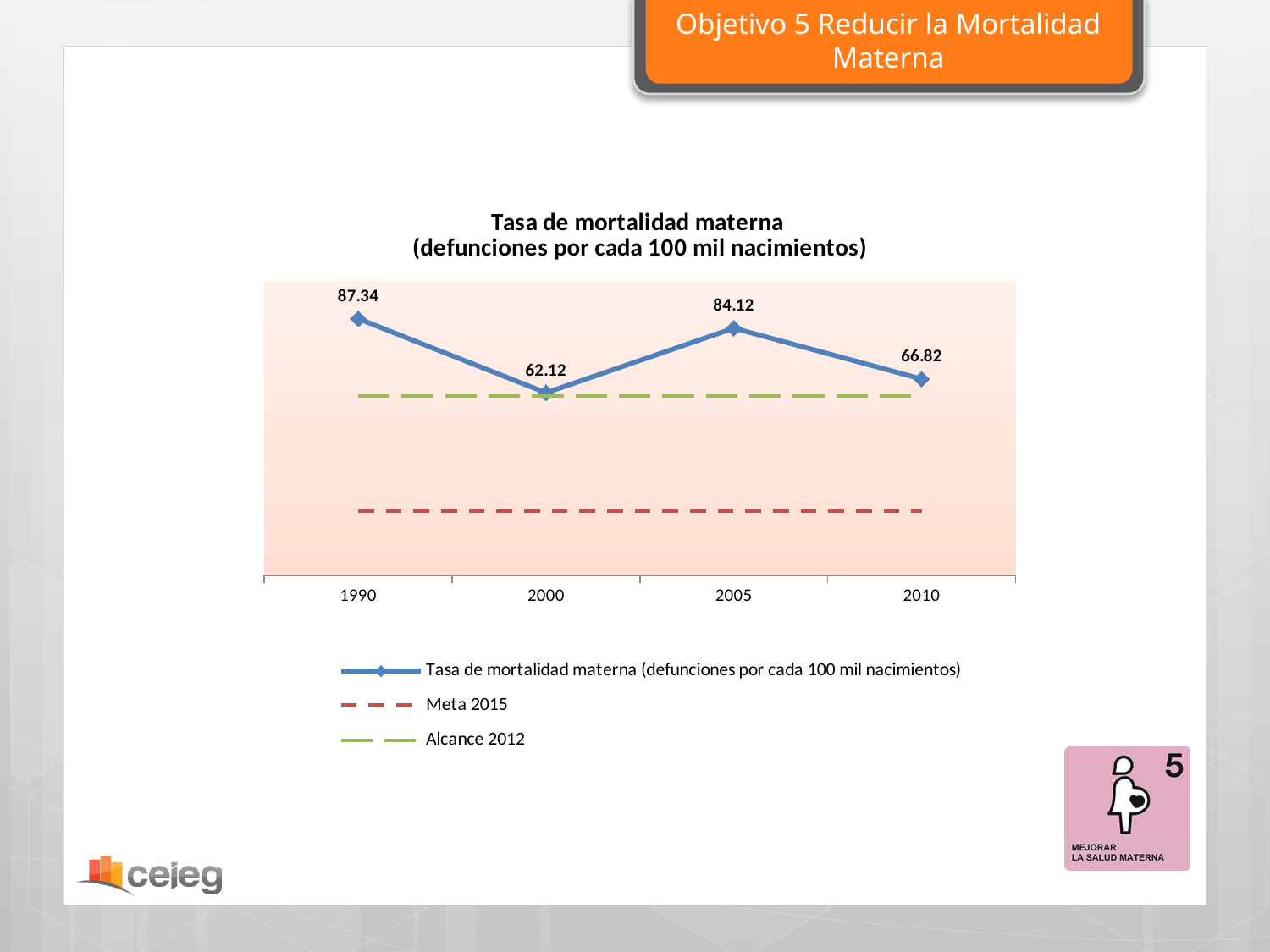
What is the maternal mortality rate shown for 2005? 84.12 What is the maternal mortality rate shown for 1990? 87.34 How many series does the legend list? 3 What is the maternal mortality rate shown for 2000? 62.12 In which year is the maternal mortality rate lowest? 2000 What kind of chart is shown on the slide? Line chart In which year is the maternal mortality rate highest? 1990 Which year has a higher maternal mortality rate, 2005 or 2010? 2005 How many years are plotted on the x axis? 4 What is the difference between the maternal mortality rate in 1990 and in 2010? 20.52 Does the maternal mortality rate rise or fall between 1990 and 2000? Fall What is the maternal mortality rate shown for 2010? 66.82